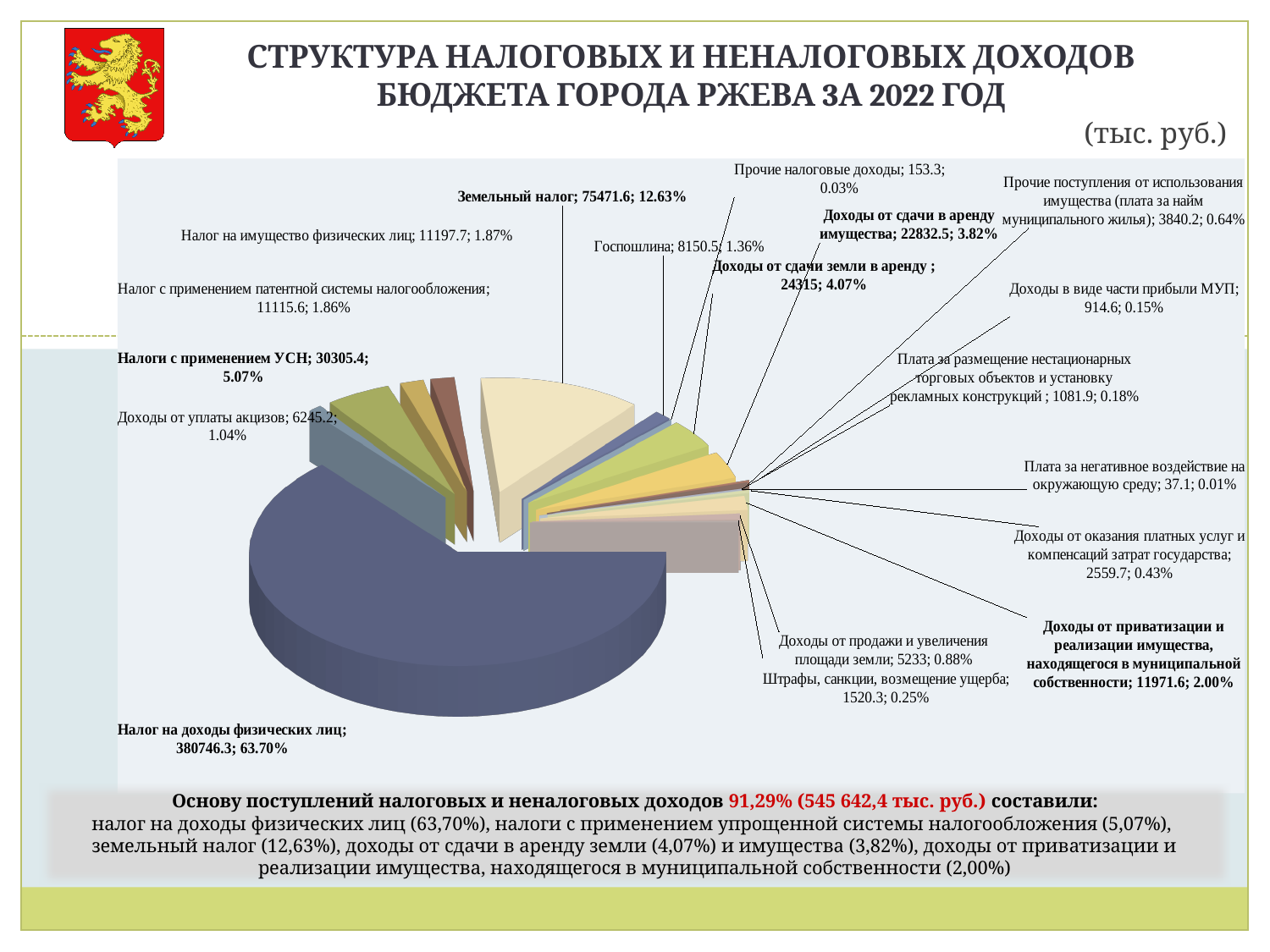
What value is shown for Земельный налог? 75471.6 What kind of chart is shown on the slide? pie chart What value is shown for Штрафы, санкции, возмещение ущерба? 1520.3 In what units are the values in the chart given, according to the slide? тыс. руб. Which category has the largest slice of the pie? Налог на доходы физических лиц Which category has the smallest slice of the pie? Плата за негативное воздействие на окружающую среду What share of the pie does Налог на доходы физических лиц represent? 63.70% How many categories are shown in the pie chart? 18 What is the difference between the values for Земельный налог and Налоги с применением УСН? 45166.2 Which is larger: Налоги с применением УСН or Доходы от сдачи в аренду имущества? Налоги с применением УСН What value is shown for Госпошлина? 8150.5 What percentage is shown for Доходы от сдачи земли в аренду? 4.07%